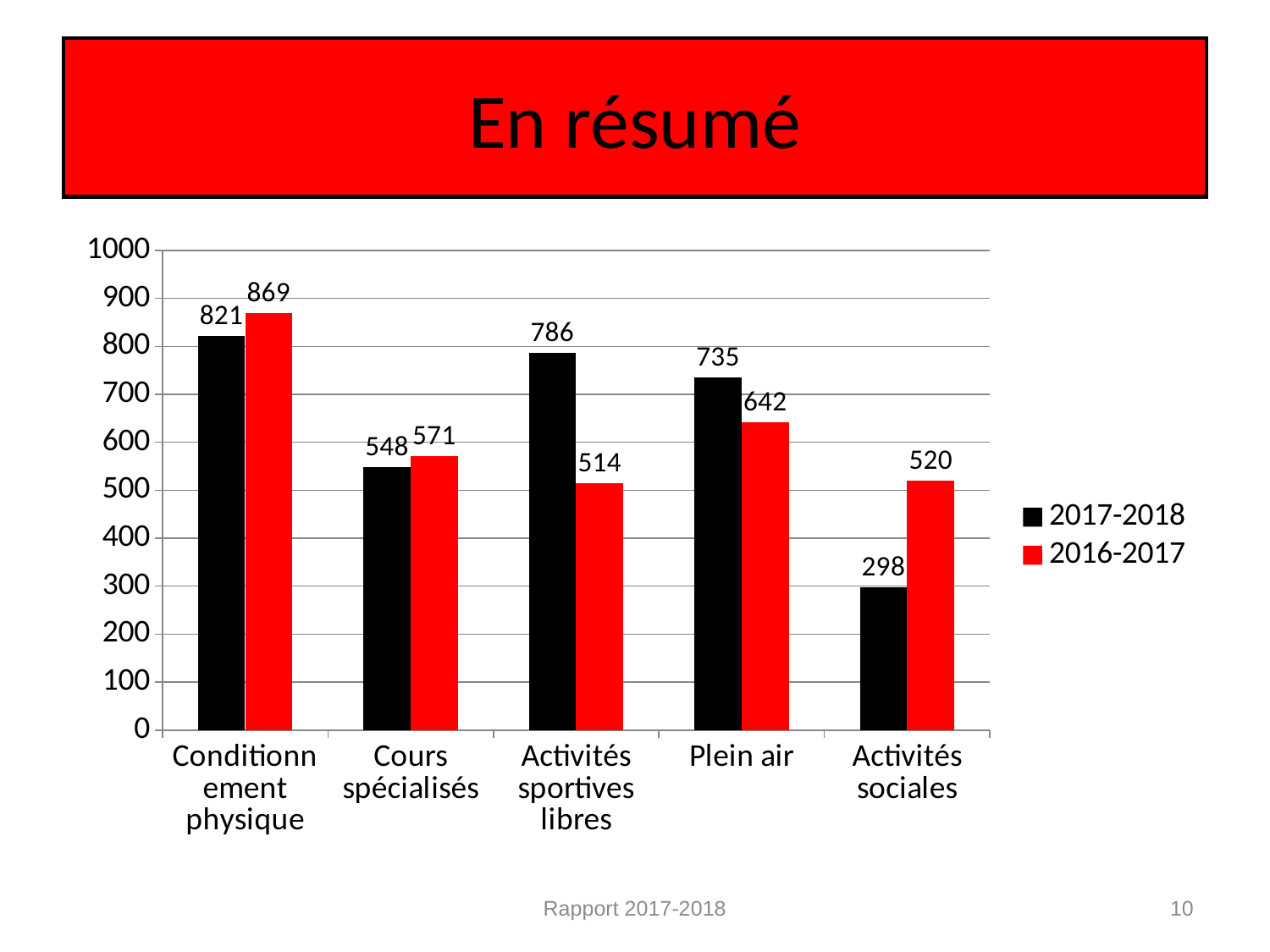
What is the value for Activités sociales in the 2016-2017 series? 520 Which category has the lowest value in the 2017-2018 series? Activités sociales How many series does the legend list? 2 How many categories are shown on the x axis? 5 Which is larger for Conditionnement physique: the 2017-2018 value or the 2016-2017 value? 2016-2017 What kind of chart is shown on the slide? bar chart What is the value for Cours spécialisés in the 2017-2018 series? 548 Is the 2017-2018 value for Activités sociales greater or less than 400? less What colour represents the 2016-2017 series? red What is the value for Plein air in the 2017-2018 series? 735 What is the difference between the 2017-2018 and 2016-2017 values for Activités sportives libres? 272 Which category has the highest value in the 2016-2017 series? Conditionnement physique